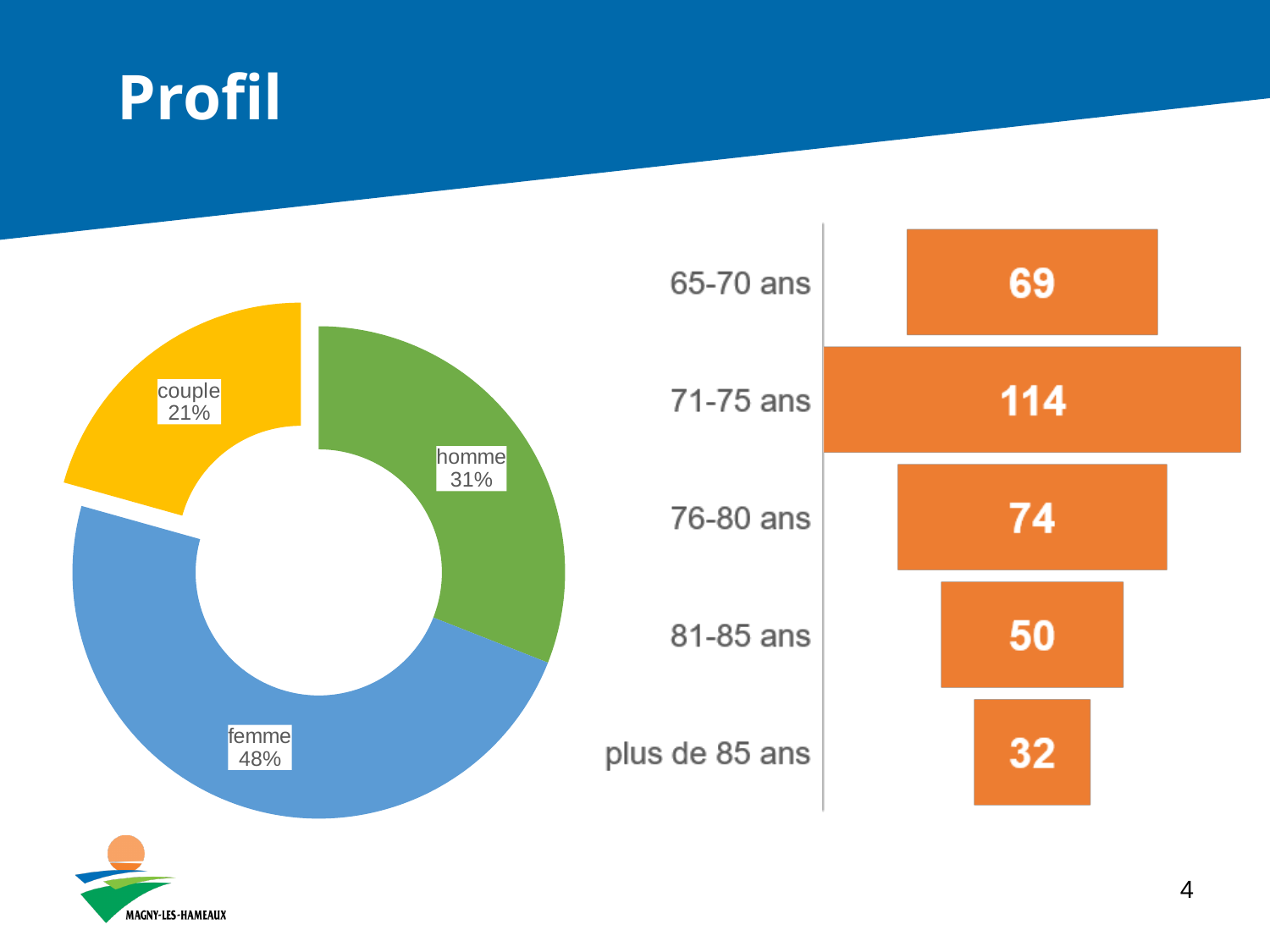
In the chart on the right, which is larger, the value for 65-70 ans or the value for 81-85 ans? 65-70 ans What kind of chart is the chart on the right? bar chart In the chart on the right, which age group has the lowest value? plus de 85 ans In the chart on the right, what is the value for 71-75 ans? 114 In the chart on the left, what share does femme have? 48% What kind of chart is the chart on the left? doughnut chart In the chart on the right, what is the difference between the values for 71-75 ans and 76-80 ans? 40 In the chart on the right, what is the value for plus de 85 ans? 32 In the chart on the left, what is the value for couple? 21% How many age groups are shown in the chart on the right? 5 In the chart on the left, which category has the largest share? femme In the chart on the right, which age group has the highest value? 71-75 ans